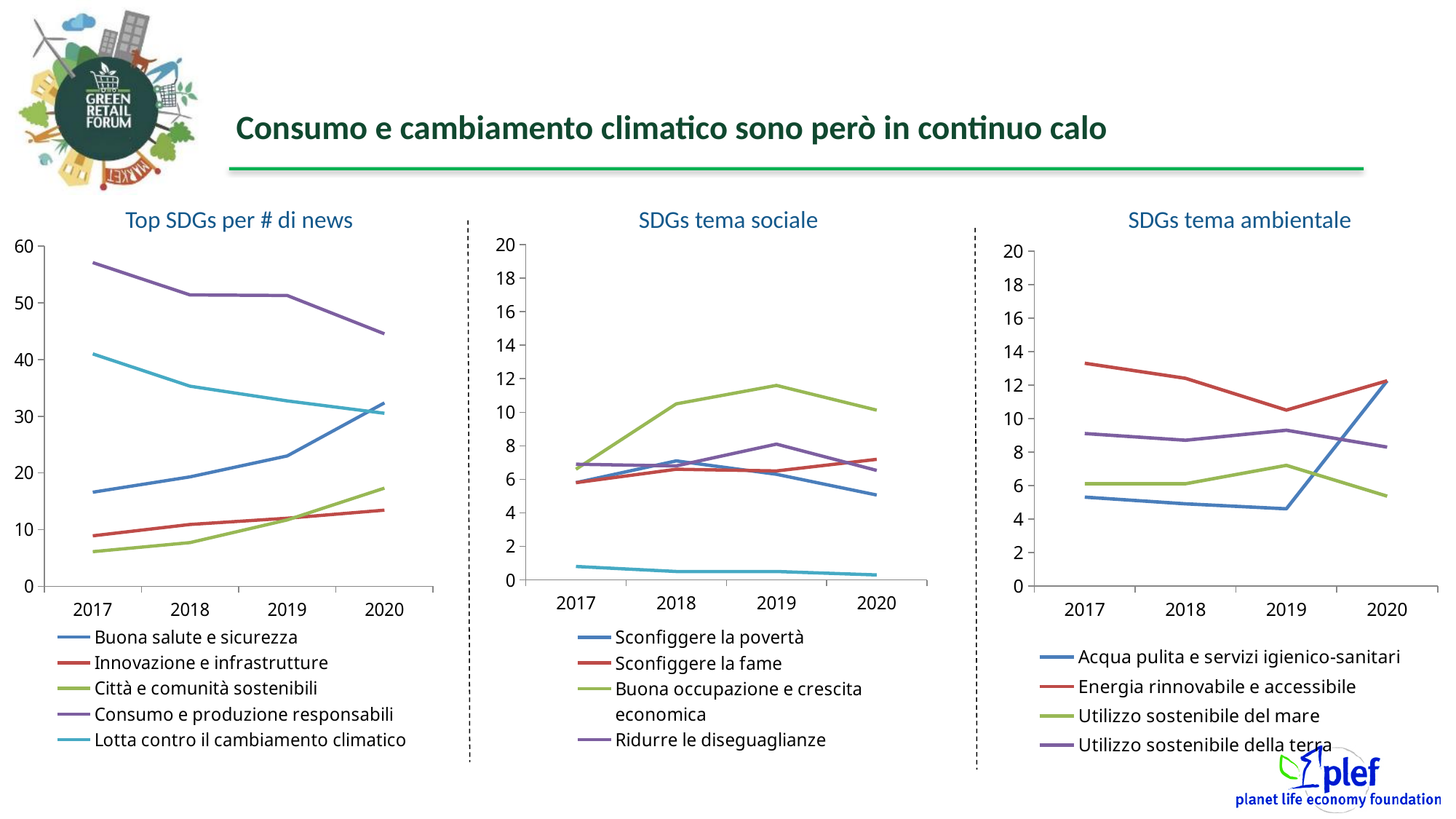
In the 'SDGs tema ambientale' chart, is the value for 'Utilizzo sostenibile del mare' in 2020 greater or less than 6? less In the 'Top SDGs per # di news' chart, does the value for 'Buona salute e sicurezza' rise or fall from 2017 to 2020? rise In the 'SDGs tema sociale' chart, which series has the highest value in 2019? Buona occupazione e crescita economica In the 'Top SDGs per # di news' chart, how many series does the legend list? 5 What kind of chart is the 'Top SDGs per # di news' chart? line chart In the 'SDGs tema sociale' chart, is the value for 'Buona occupazione e crescita economica' in 2019 greater or less than 10? greater In the 'Top SDGs per # di news' chart, which series has the highest value in 2017? Consumo e produzione responsabili In the 'Top SDGs per # di news' chart, does the value for 'Lotta contro il cambiamento climatico' rise or fall from 2017 to 2020? fall In the 'SDGs tema sociale' chart, how many series does the legend list? 4 In the 'SDGs tema ambientale' chart, which series has the highest value in 2017? Energia rinnovabile e accessibile In the 'Top SDGs per # di news' chart, how many years are shown on the x axis? 4 In the 'Top SDGs per # di news' chart, is the value for 'Consumo e produzione responsabili' in 2017 greater or less than 50? greater